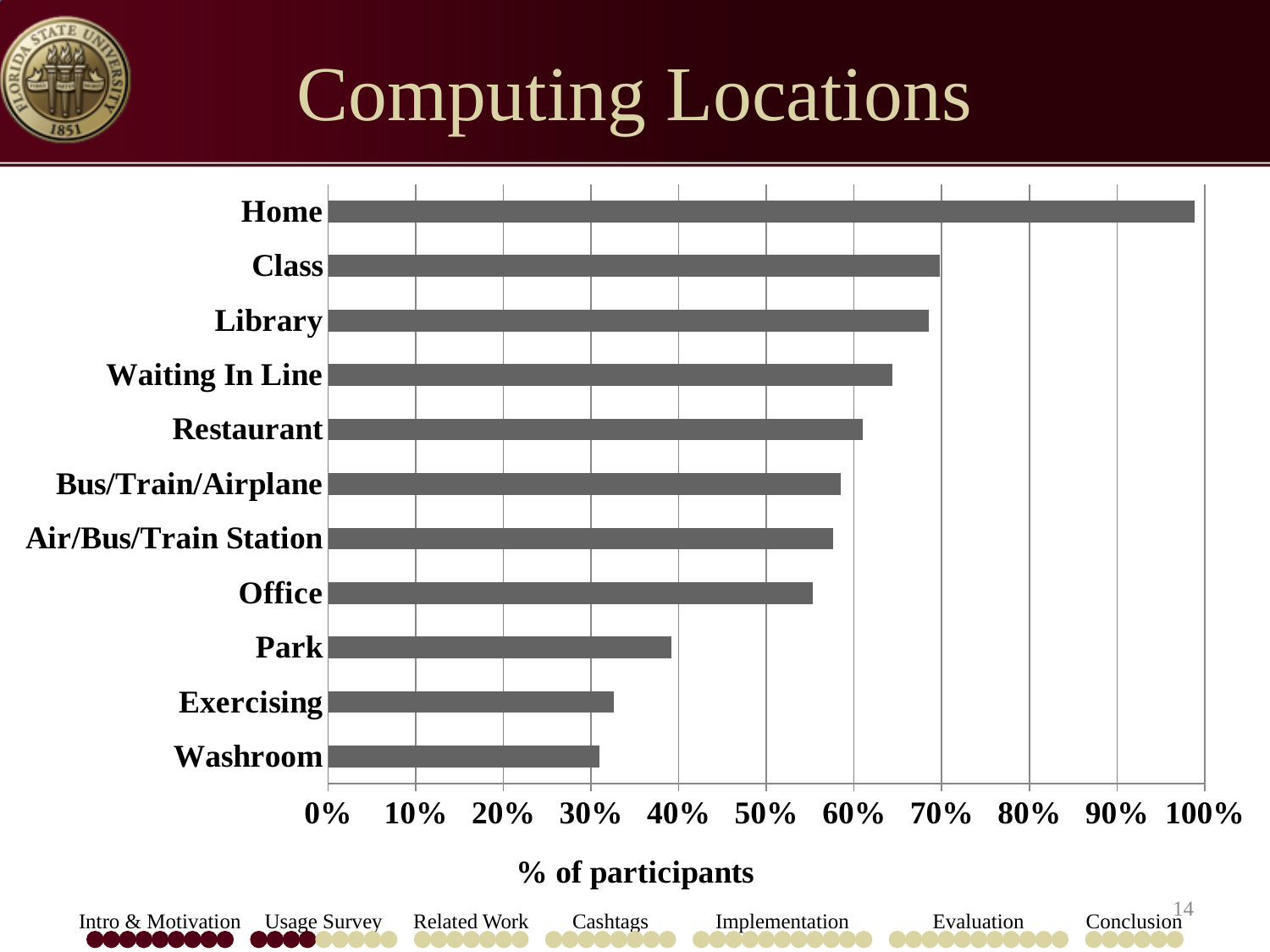
Is the value for Bus/Train/Airplane greater or less than 50%? greater Is the value for Waiting In Line greater or less than 60%? greater Is the value for Office greater or less than 60%? less Which has a higher percentage of participants, Library or Waiting In Line? Library What is the label on the horizontal axis of the chart? % of participants How many computing locations are listed on the chart? 11 Which has a higher percentage of participants, Park or Office? Office What kind of chart is shown on the slide? bar chart Which computing location has the highest percentage of participants? Home